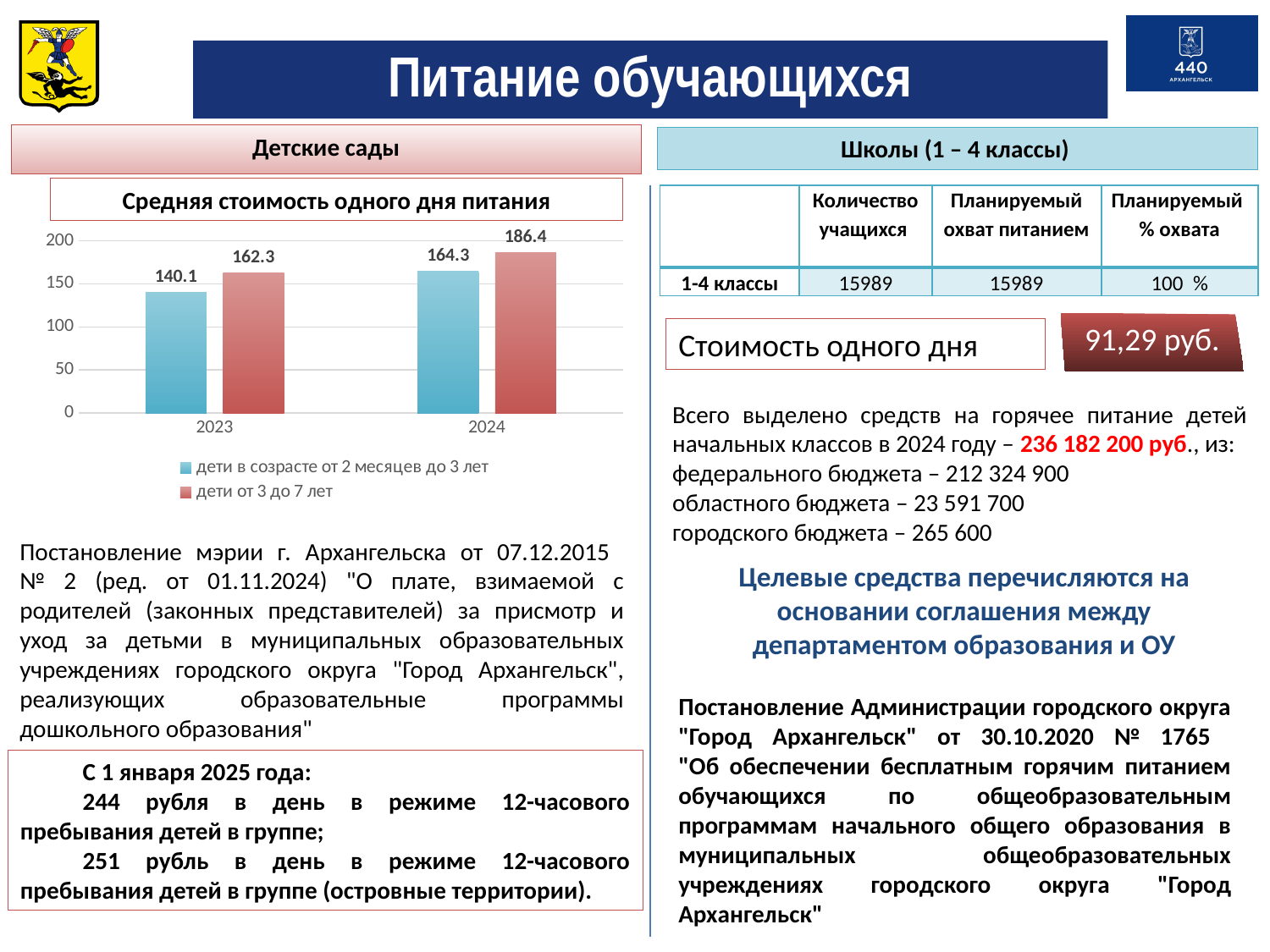
What is the difference between the 2024 and 2023 values for children aged 3 to 7 years? 24.1 What is the value for children aged 3 to 7 years in 2023? 162.3 What is the value for children aged 2 months to 3 years (дети в созрасте от 2 месяцев до 3 лет) in 2023? 140.1 Which series has the lowest value in 2023? дети в созрасте от 2 месяцев до 3 лет What is the value for children aged 3 to 7 years (дети от 3 до 7 лет) in 2024? 186.4 What is the difference between the two series in 2024? 22.1 How many series does the chart legend list? 2 What kind of chart is shown on the slide? bar chart Which year has the highest value for children aged 2 months to 3 years? 2024 Do the values for children aged 3 to 7 years rise or fall from 2023 to 2024? rise How many years (categories) are shown on the x axis of the chart? 2 Which is larger: the 2024 value for children aged 2 months to 3 years or the 2023 value for children aged 3 to 7 years? 2024 value for children aged 2 months to 3 years